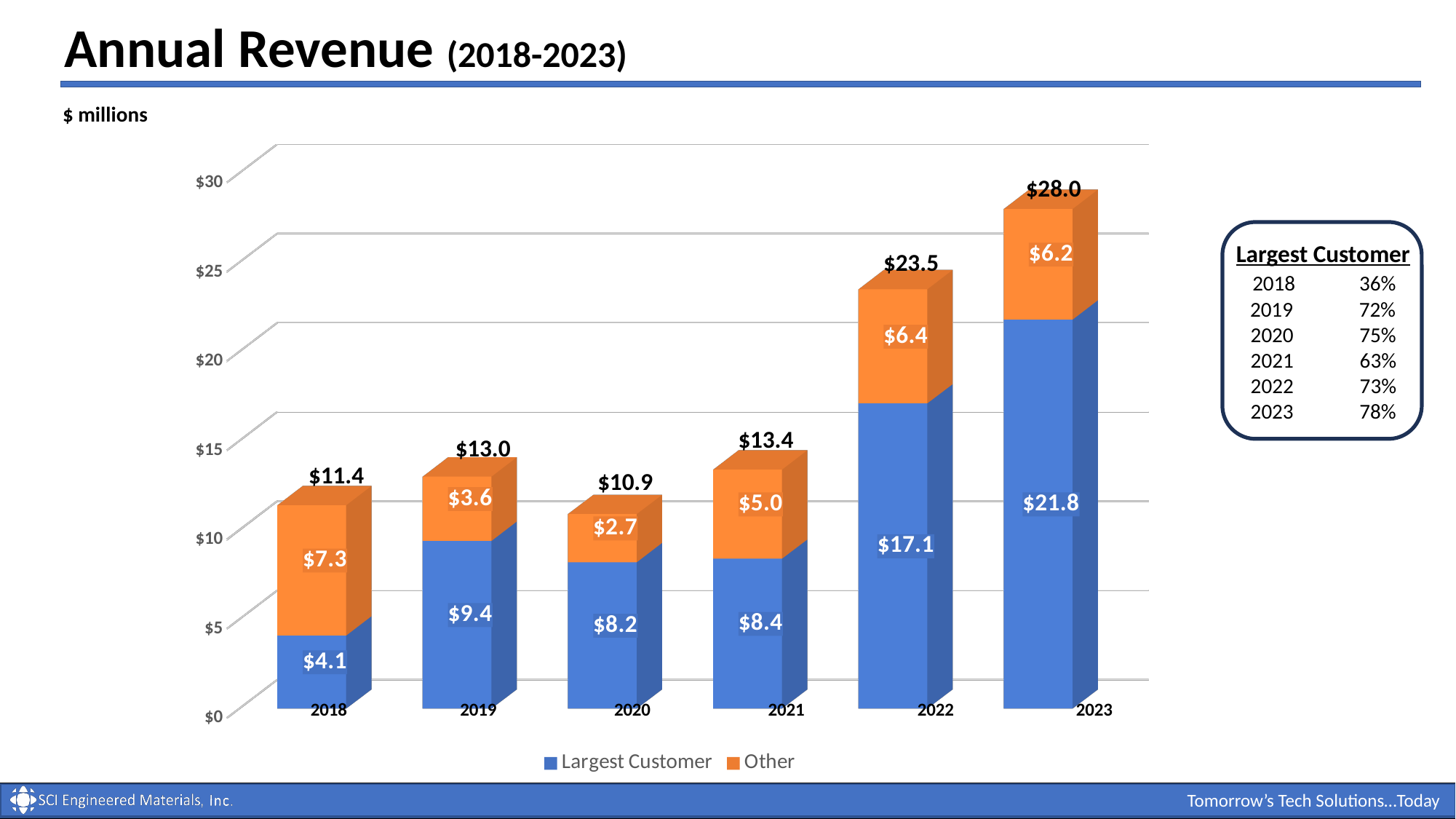
What is the Largest Customer revenue for 2021? $8.4 What is the total revenue shown for 2022? $23.5 How many series does the legend list? 2 Which year has the lowest total revenue? 2020 What is the difference between the Largest Customer revenue in 2023 and in 2022? $4.7 What unit is stated for the values on the chart? $ millions What kind of chart is shown? Stacked bar chart Which is larger, the Other revenue in 2022 or in 2023? 2022 What is the Other revenue for 2018? $7.3 Which year has the highest total revenue? 2023 How many years are shown on the x axis? 6 Does total revenue rise or fall from 2021 to 2023? Rise